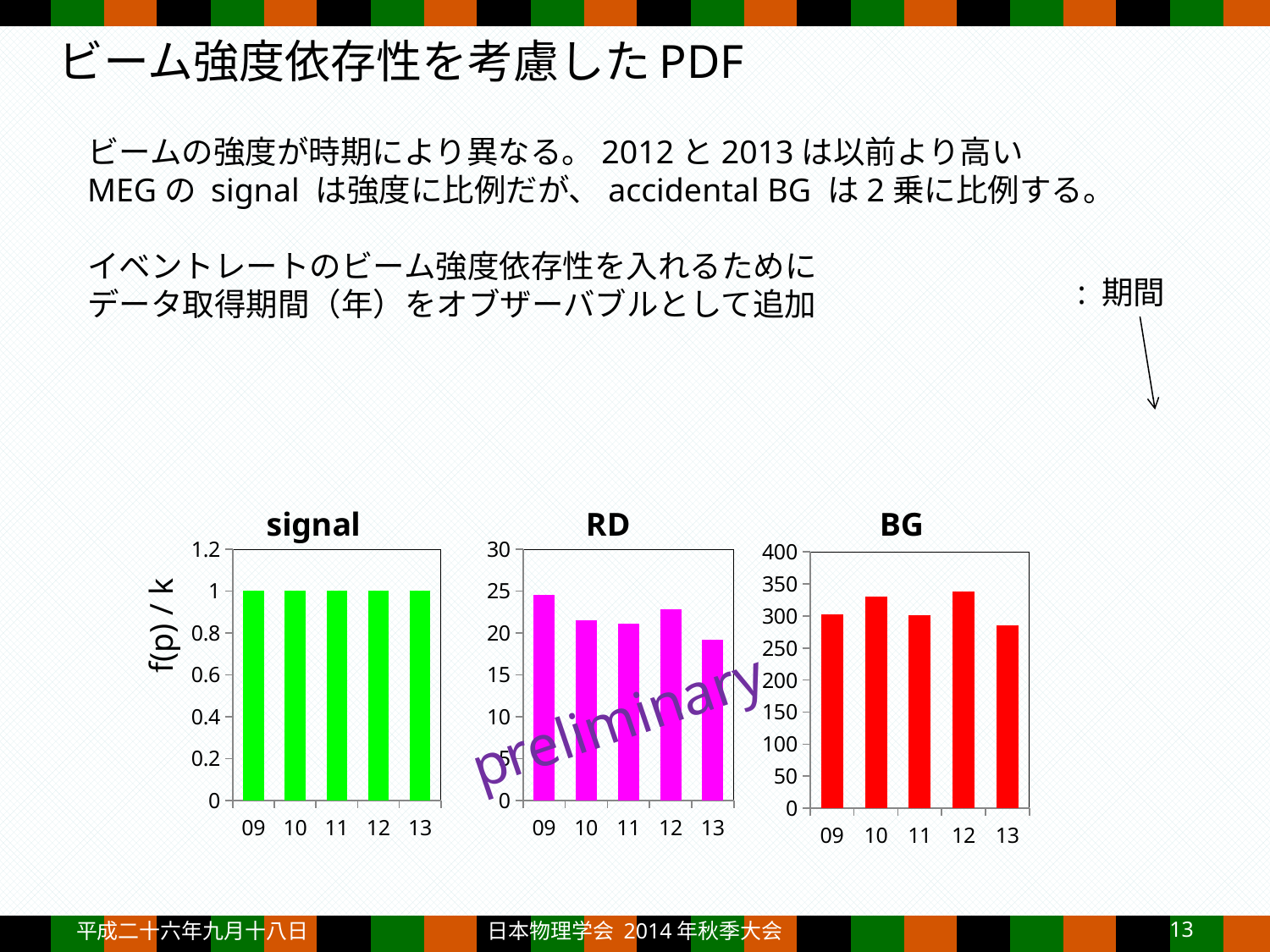
In the signal chart, what is the value for 09? 1 In the BG chart, is the value for 13 greater or less than 300? less In the BG chart, which category has the lowest value? 13 How many categories does the RD chart show? 5 In the RD chart, is the value for 09 greater or less than 20? greater In the signal chart, what is the value for 13? 1 In the RD chart, which category has the highest value? 09 In the BG chart, is the value for 12 greater or less than 300? greater What kind of chart is the BG chart? bar chart In the RD chart, which category has the lowest value? 13 In the BG chart, which is larger, the value for 10 or the value for 13? 10